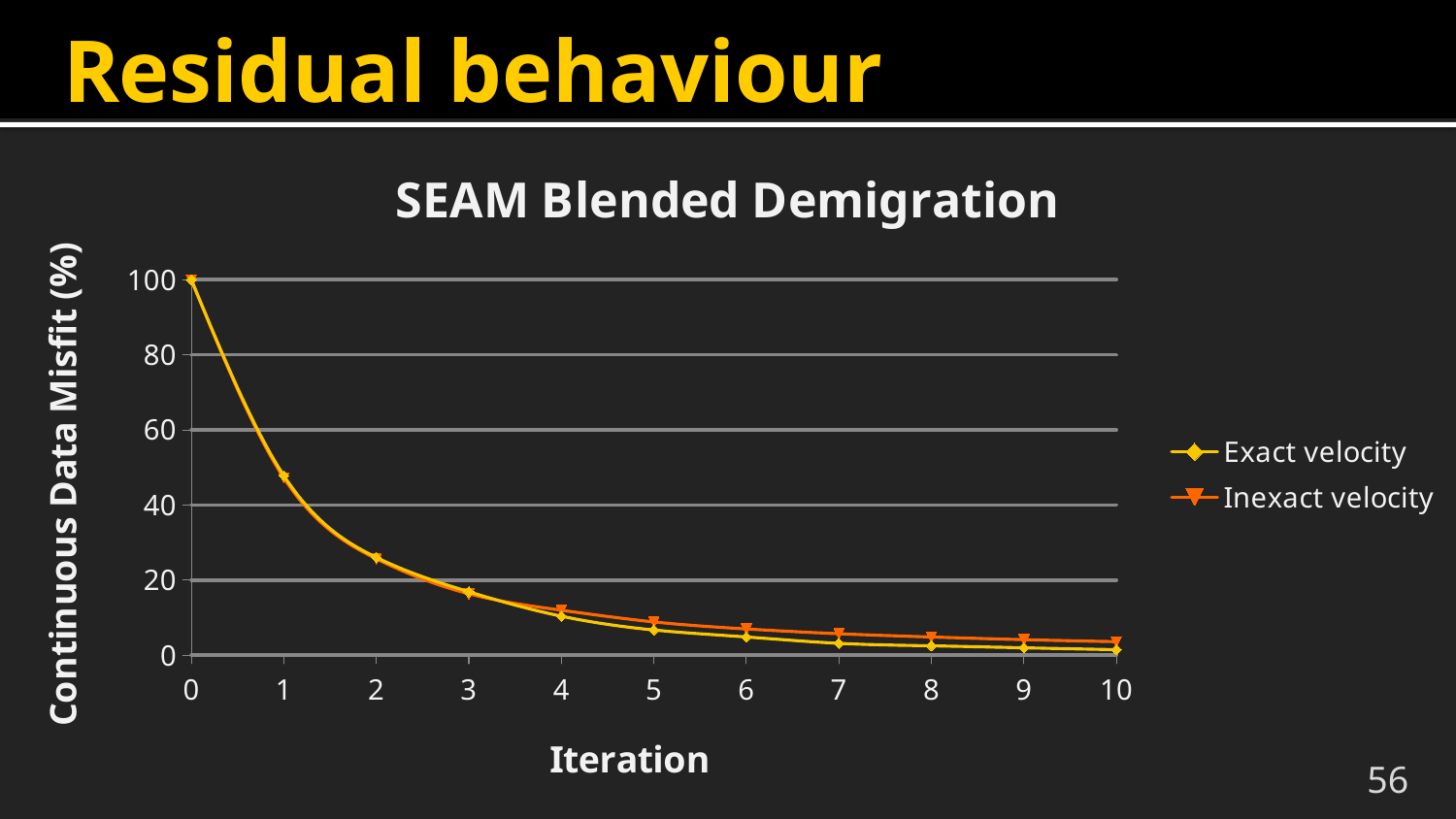
Is the Inexact velocity misfit at iteration 2 greater or less than 20? greater What is the label of the y axis? Continuous Data Misfit (%) Is the Exact velocity misfit at iteration 1 greater or less than 60? less How many iteration points are plotted along the x axis for each series? 11 What is the title of the chart? SEAM Blended Demigration Do the misfit values rise or fall as the iteration number increases? fall How many series does the legend list? 2 At which iteration is the Inexact velocity misfit highest? 0 What type of chart is shown on the slide? line chart What is the Continuous Data Misfit (%) for Exact velocity at iteration 0? 100 At iteration 8, which series has the higher misfit, Exact velocity or Inexact velocity? Inexact velocity At which iteration is the Exact velocity misfit lowest? 10